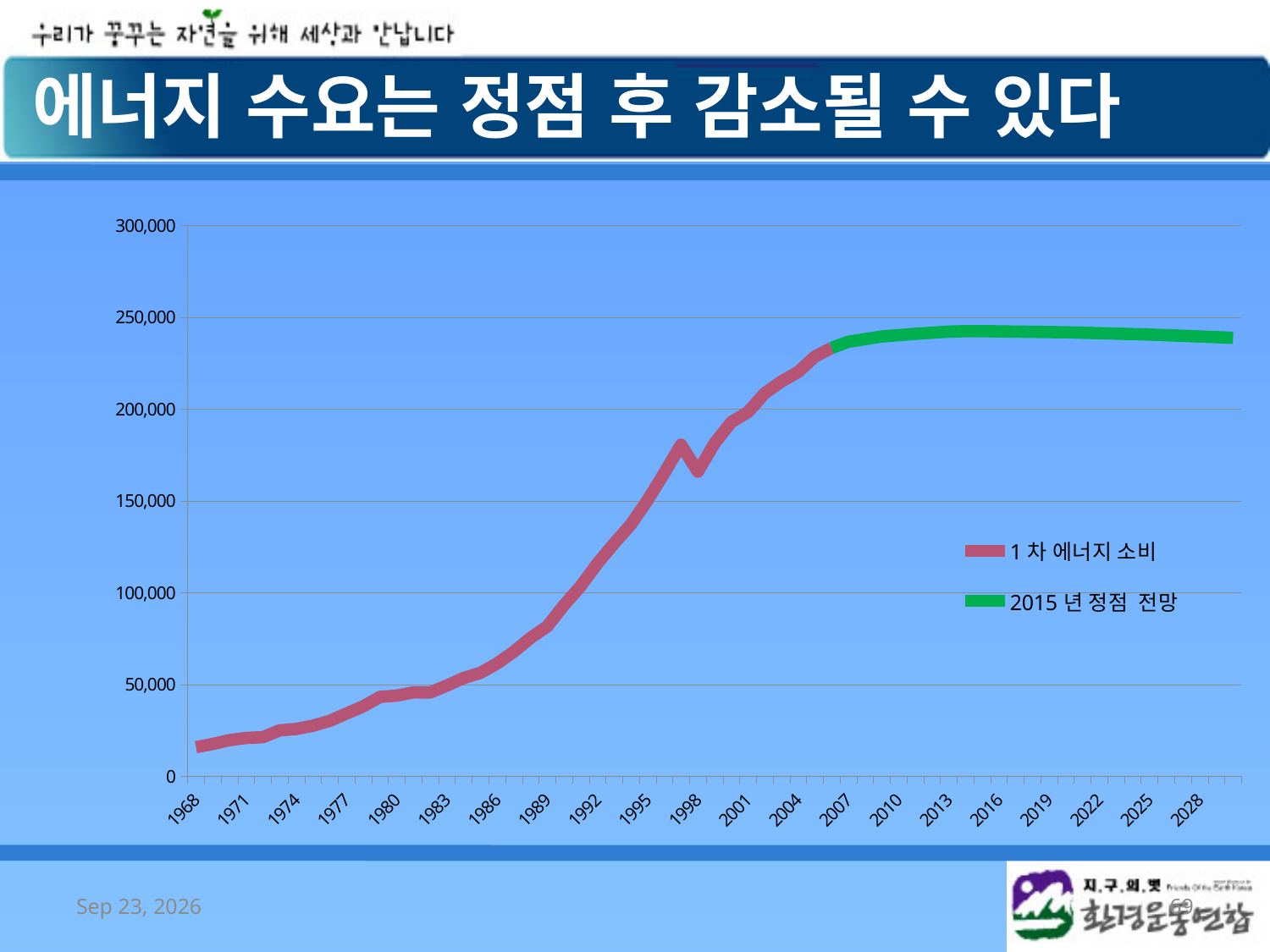
Is the value for 1989 greater or less than 100,000? less Which is larger, the value for 1995 or the value for 1998? 1998 How many series does the legend list? 2 What kind of chart is shown on the slide? line chart What are the two series named in the legend? 1 차 에너지 소비 and 2015 년 정점 전망 Is the value for 2028 greater or less than 250,000? less Is the value for 1968 greater or less than 50,000? less What colour is the line for the series 2015 년 정점 전망? green Does the 1 차 에너지 소비 series generally rise or fall from 1968 to 2007? rise Which year has the lowest value on the chart? 1968